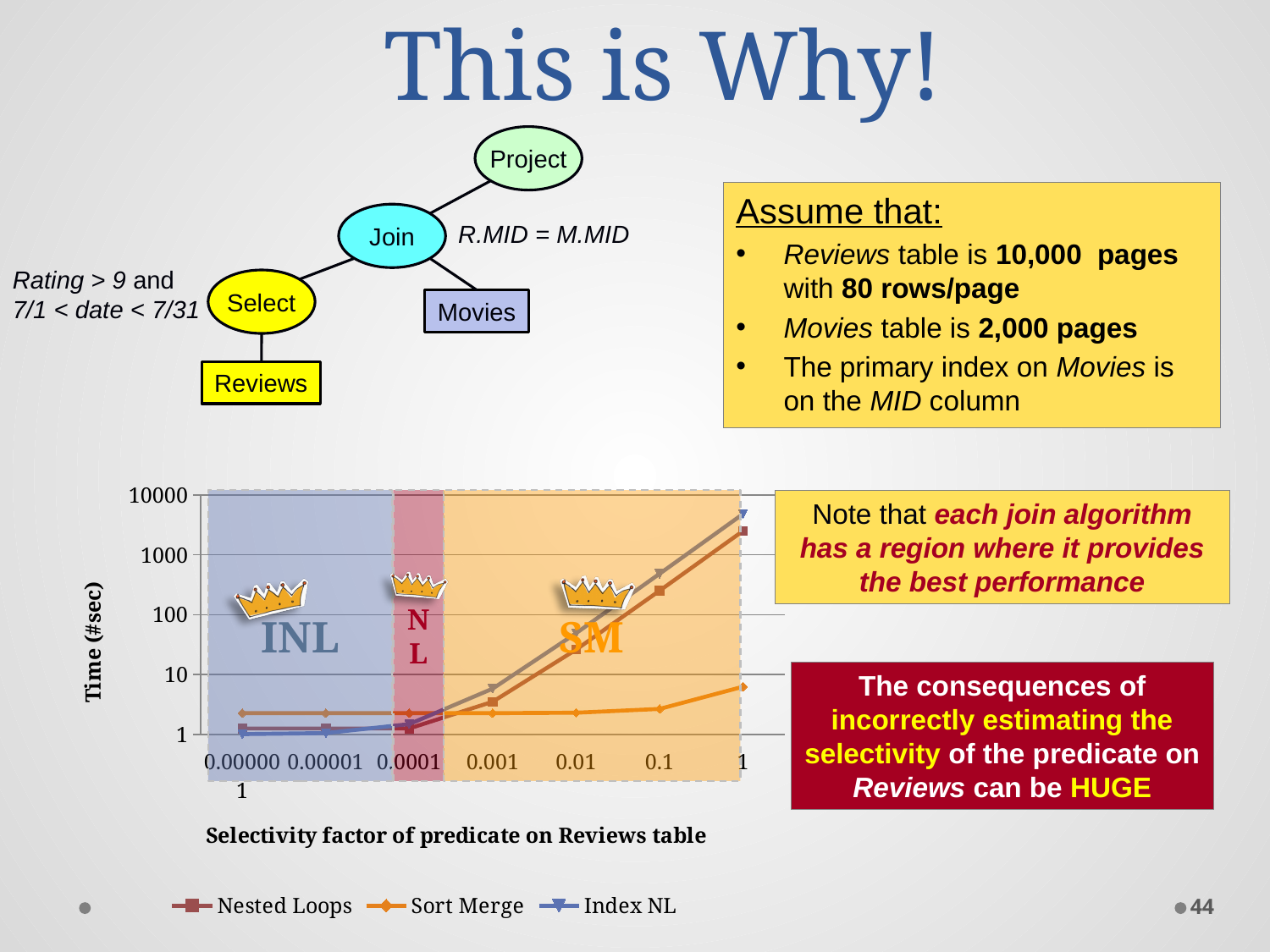
Is the Sort Merge time at a selectivity factor of 1 greater or less than 10? less At a selectivity factor of 0.000001, which series has the higher time: Sort Merge or Nested Loops? Sort Merge How many series does the chart legend list? 3 Which series has the lowest time at a selectivity factor of 1? Sort Merge What is the title of the chart's x axis? Selectivity factor of predicate on Reviews table Is the Index NL time at a selectivity factor of 1 greater or less than 1000? greater Does the Index NL time rise or fall as the selectivity factor increases along the x axis? rise Which series has the highest time at a selectivity factor of 1? Index NL What kind of chart is shown on the slide? line chart Is the Nested Loops time at a selectivity factor of 0.001 greater or less than 10? less How many selectivity factor values are plotted along the x axis? 7